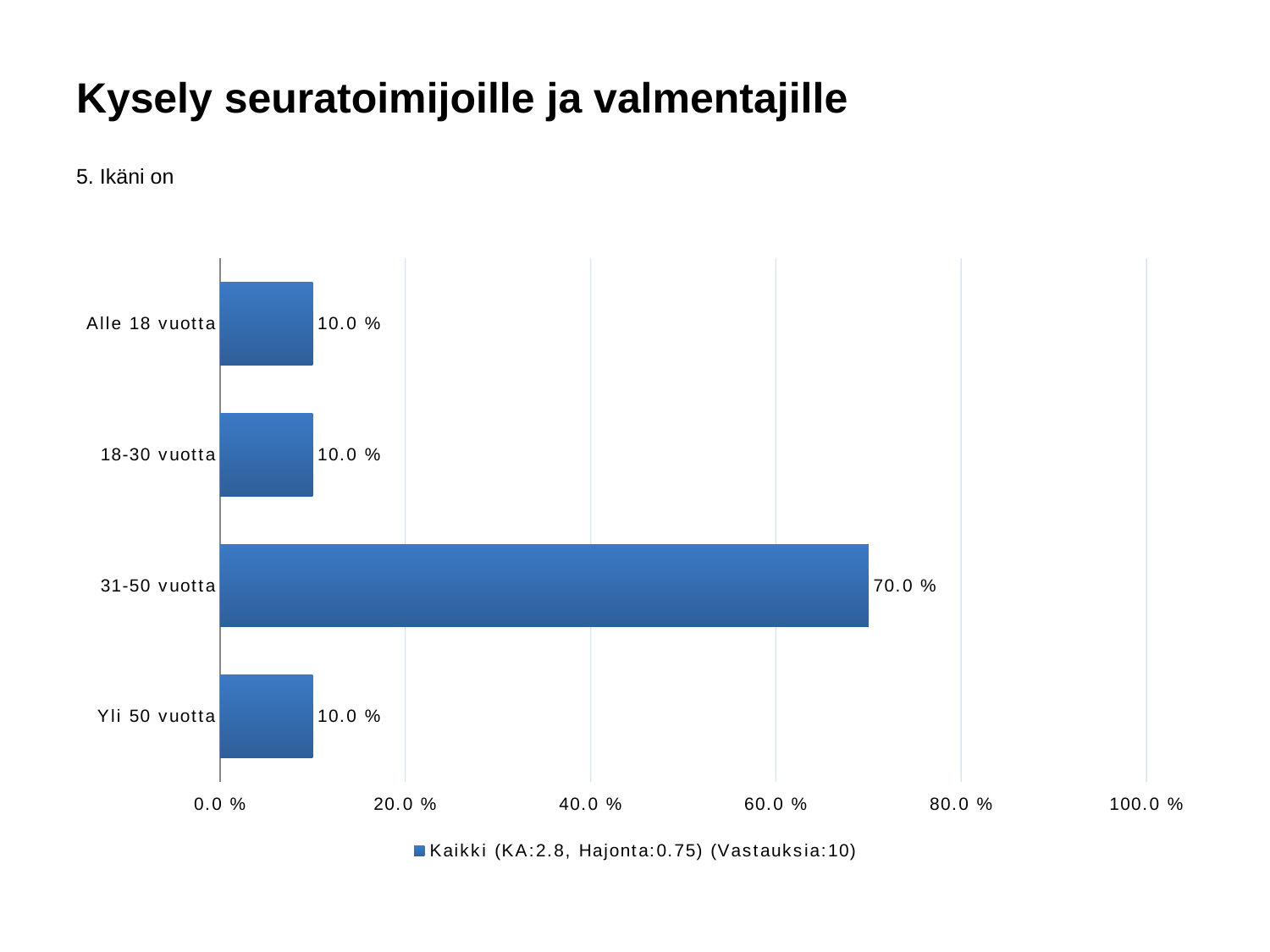
Which is larger, the value for 31-50 vuotta or the value for Yli 50 vuotta? 31-50 vuotta What is the legend entry of the chart? Kaikki (KA:2.8, Hajonta:0.75) (Vastauksia:10) What is the value for 31-50 vuotta? 70.0 % What is the value for Alle 18 vuotta? 10.0 % What is the difference between the values for 31-50 vuotta and 18-30 vuotta? 60.0 % Which category has the highest value? 31-50 vuotta Is the value for 31-50 vuotta greater or less than 60.0 %? greater What is the value for Yli 50 vuotta? 10.0 % Is the value for 18-30 vuotta greater or less than 20.0 %? less What kind of chart is shown on the slide? Bar chart How many series does the legend list? 1 How many categories are shown in the chart? 4